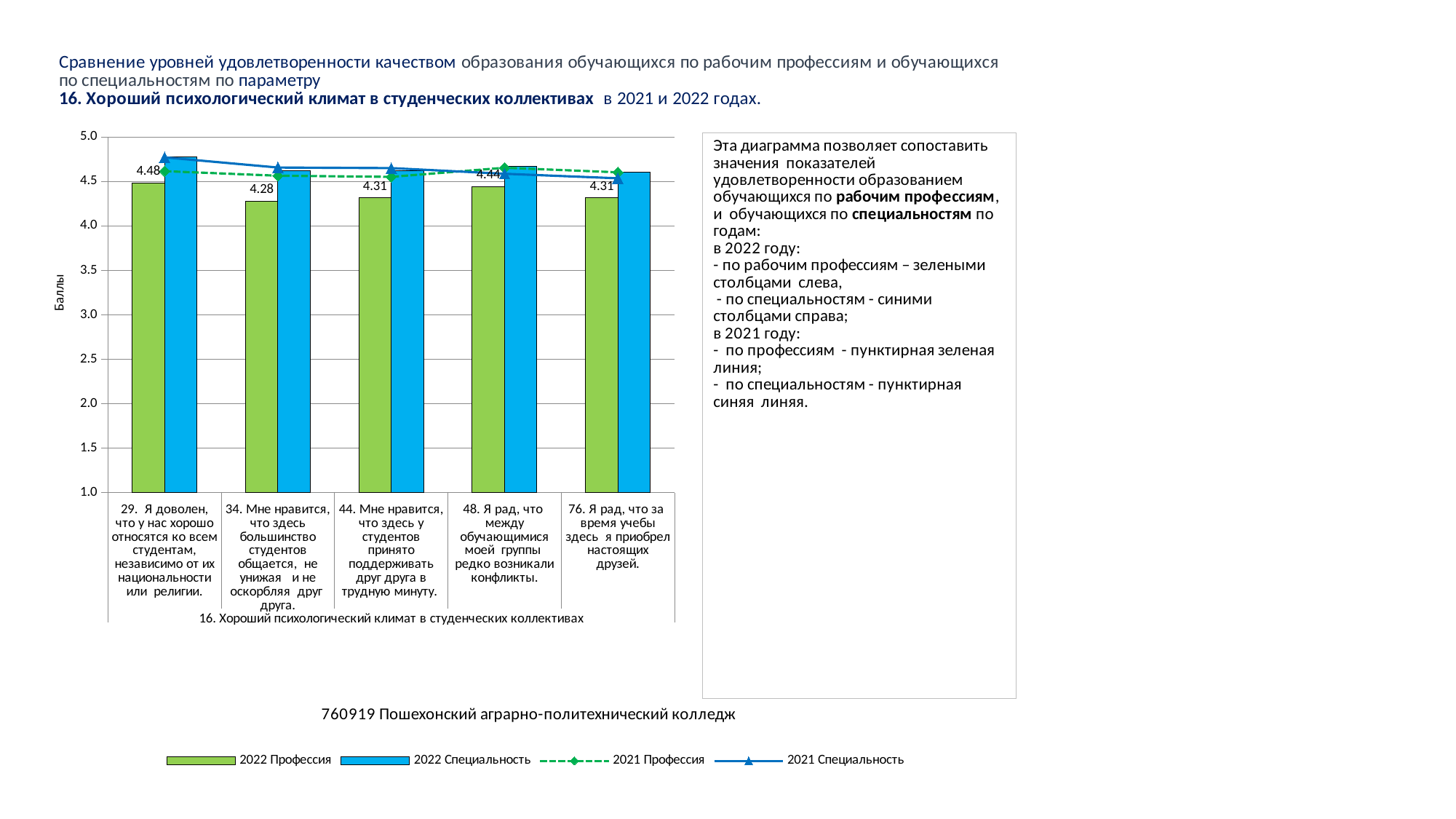
How many series does the legend list? 4 What is the difference between the 2022 Профессия values for statement 29 and statement 34? 0.20 Which statement has the highest 2022 Профессия value? 29. Я доволен, что у нас хорошо относятся ко всем студентам, независимо от их национальности или религии. What is the value of the 2022 Профессия bar for statement 29 (Я доволен, что у нас хорошо относятся ко всем студентам...)? 4.48 Is the 2022 Специальность value for statement 29 greater or less than 4.5? greater What is the value of the 2022 Профессия bar for statement 34 (Мне нравится, что здесь большинство студентов общается, не унижая и не оскорбляя друг друга)? 4.28 What is the value of the 2022 Профессия bar for statement 48 (Я рад, что между обучающимися моей группы редко возникали конфликты)? 4.44 What is the title of the vertical axis? Баллы What kind of chart is shown on the slide? A bar chart combined with line series For statement 29, which is larger: the 2022 Профессия bar or the 2022 Специальность bar? 2022 Специальность Which statement has the lowest 2022 Профессия value? 34. Мне нравится, что здесь большинство студентов общается, не унижая и не оскорбляя друг друга. How many statements (categories) are shown on the x axis? 5